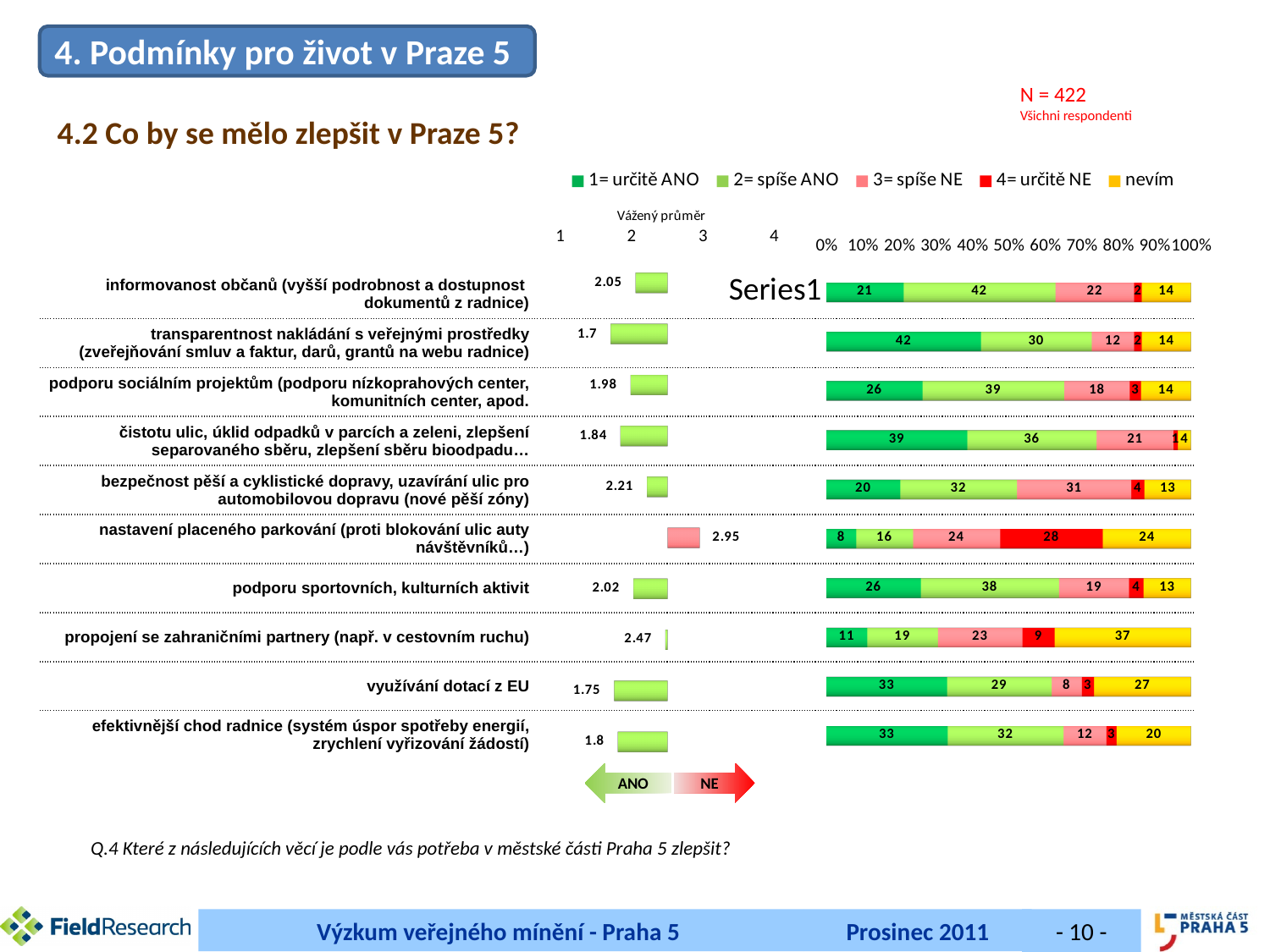
In the weighted average chart (Vážený průměr), which item has the highest weighted average? nastavení placeného parkování (proti blokování ulic auty návštěvníků…) What type of chart is the chart on the right of the slide? stacked bar chart In the weighted average chart (Vážený průměr), what is the difference between the values for 'propojení se zahraničními partnery' and 'podporu sportovních, kulturních aktivit'? 0.45 How many items (categories) are shown in the stacked bar chart? 10 In the weighted average chart (Vážený průměr), what is the value for 'využívání dotací z EU'? 1.75 In the weighted average chart (Vážený průměr), what is the value for 'nastavení placeného parkování'? 2.95 In the stacked bar chart on the right, which is larger for 'bezpečnost pěší a cyklistické dopravy': the '2= spíše ANO' value or the '3= spíše NE' value? 2= spíše ANO In the stacked bar chart on the right, what is the 'nevím' value for 'propojení se zahraničními partnery'? 37 In the weighted average chart (Vážený průměr), which item has the lowest weighted average? transparentnost nakládání s veřejnými prostředky How many series does the legend of the stacked bar chart list? 5 In the stacked bar chart on the right, what is the '1= určitě ANO' value for 'transparentnost nakládání s veřejnými prostředky'? 42 In the stacked bar chart on the right, what is the '4= určitě NE' value for 'nastavení placeného parkování'? 28